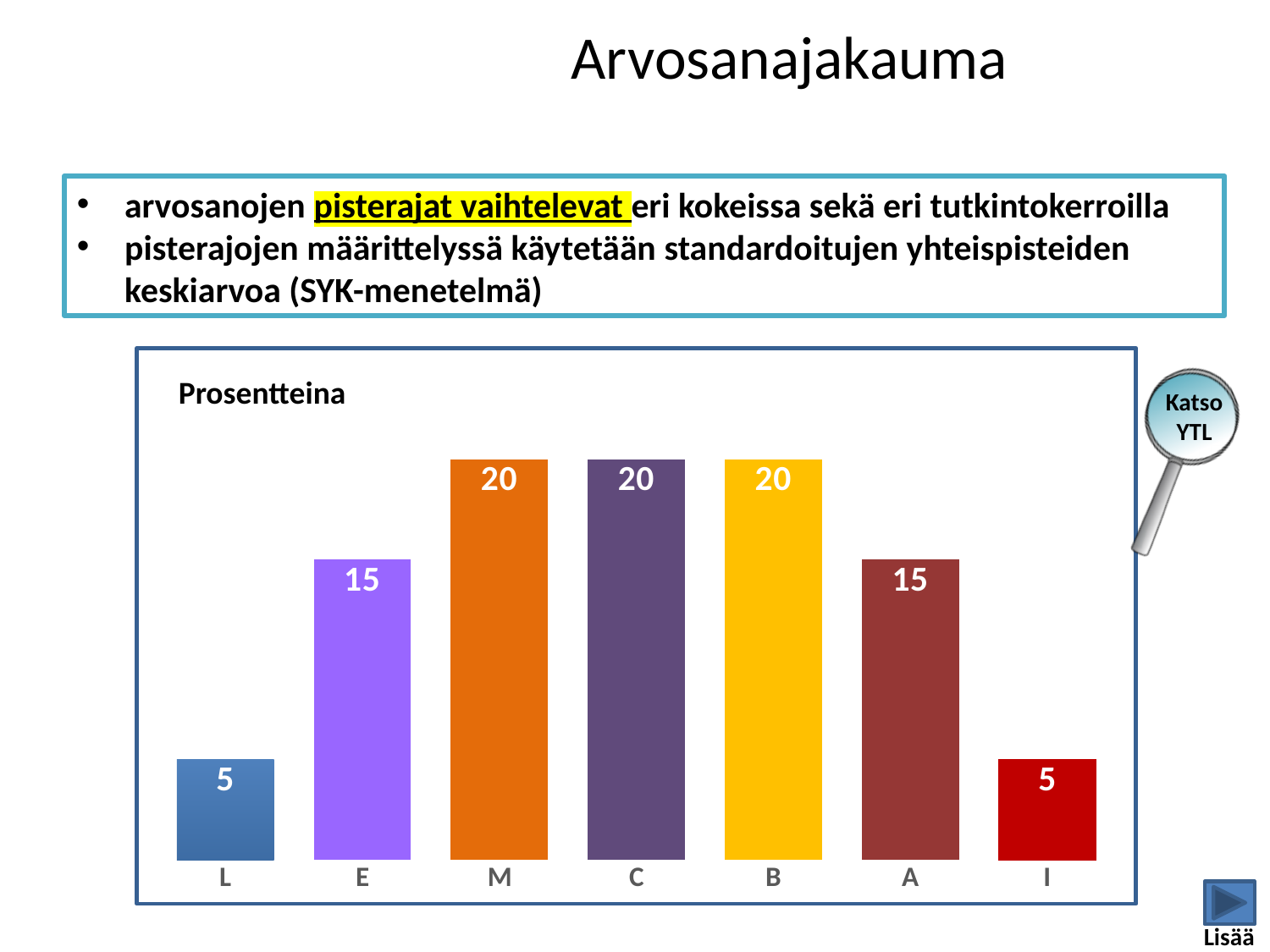
Which is larger, the value for E or the value for C? C What is the difference between the values for B and I? 15 What is the value for category L? 5 What is the value for category A? 15 What is the value for category M? 20 What is the total of the values for L, E and M? 40 What is the value for category I? 5 What is the difference between the values for M and E? 5 How many categories are shown on the x axis? 7 What kind of chart is shown on the slide? bar chart Which is larger, the value for A or the value for L? A What label appears in the top-left corner of the chart area? Prosentteina